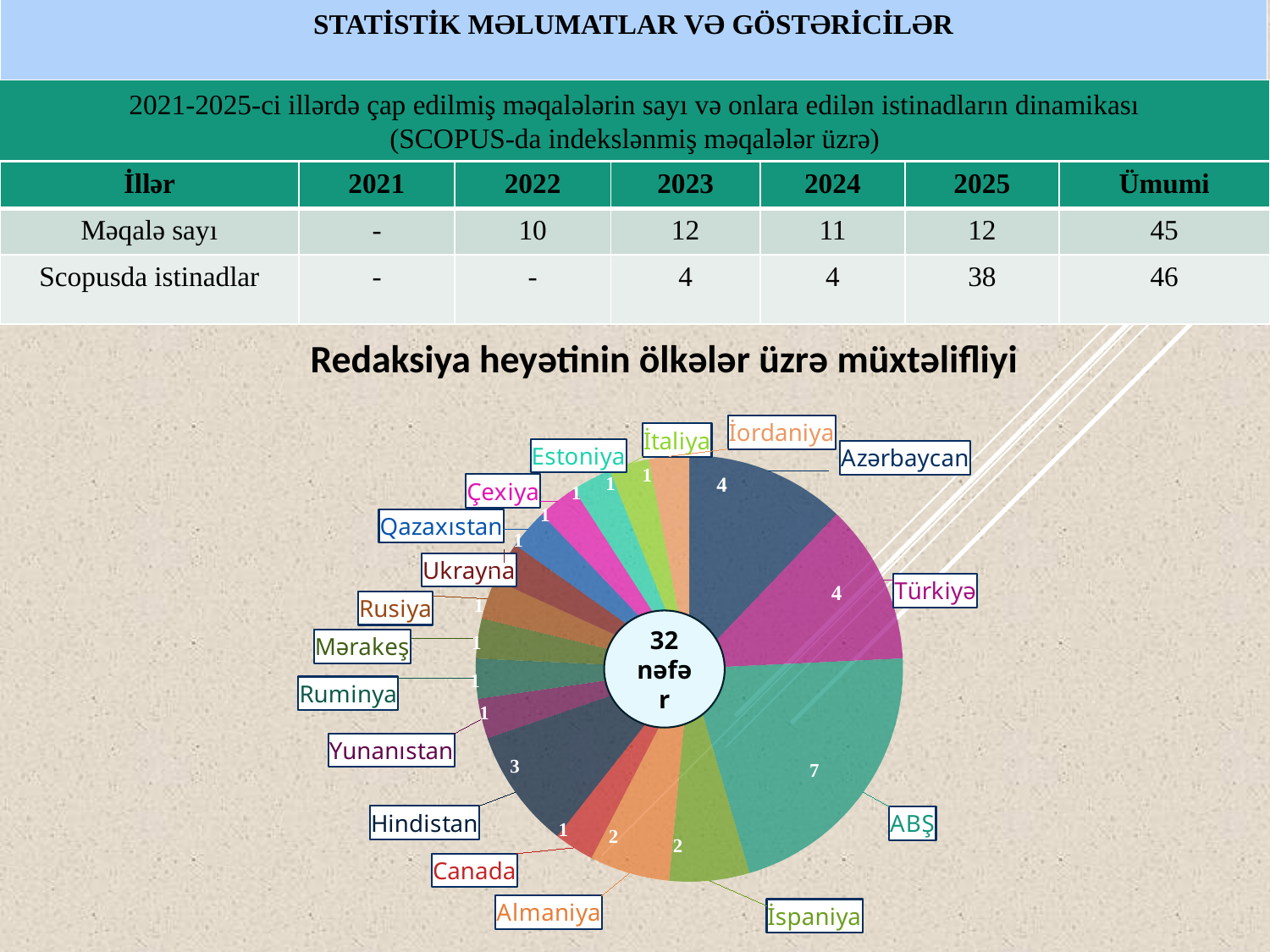
Which country has the largest slice in the pie chart? ABŞ In the pie chart, what is the difference between the value for ABŞ and the value for Türkiyə? 3 What kind of chart is shown under the heading "Redaksiya heyətinin ölkələr üzrə müxtəlifliyi"? pie chart In the pie chart, what is the difference between the value for ABŞ and the value for Hindistan? 4 How many countries are labelled in the pie chart? 17 What is the title of the pie chart? Redaksiya heyətinin ölkələr üzrə müxtəlifliyi In the pie chart, what value is shown for İspaniya? 2 What text is written in the centre of the pie chart? 32 nəfər In the pie chart, what value is shown for ABŞ? 7 In the pie chart, what value is shown for Hindistan? 3 In the pie chart, which is larger: the value for Hindistan or the value for Almaniya? Hindistan In the pie chart, what value is shown for Azərbaycan? 4